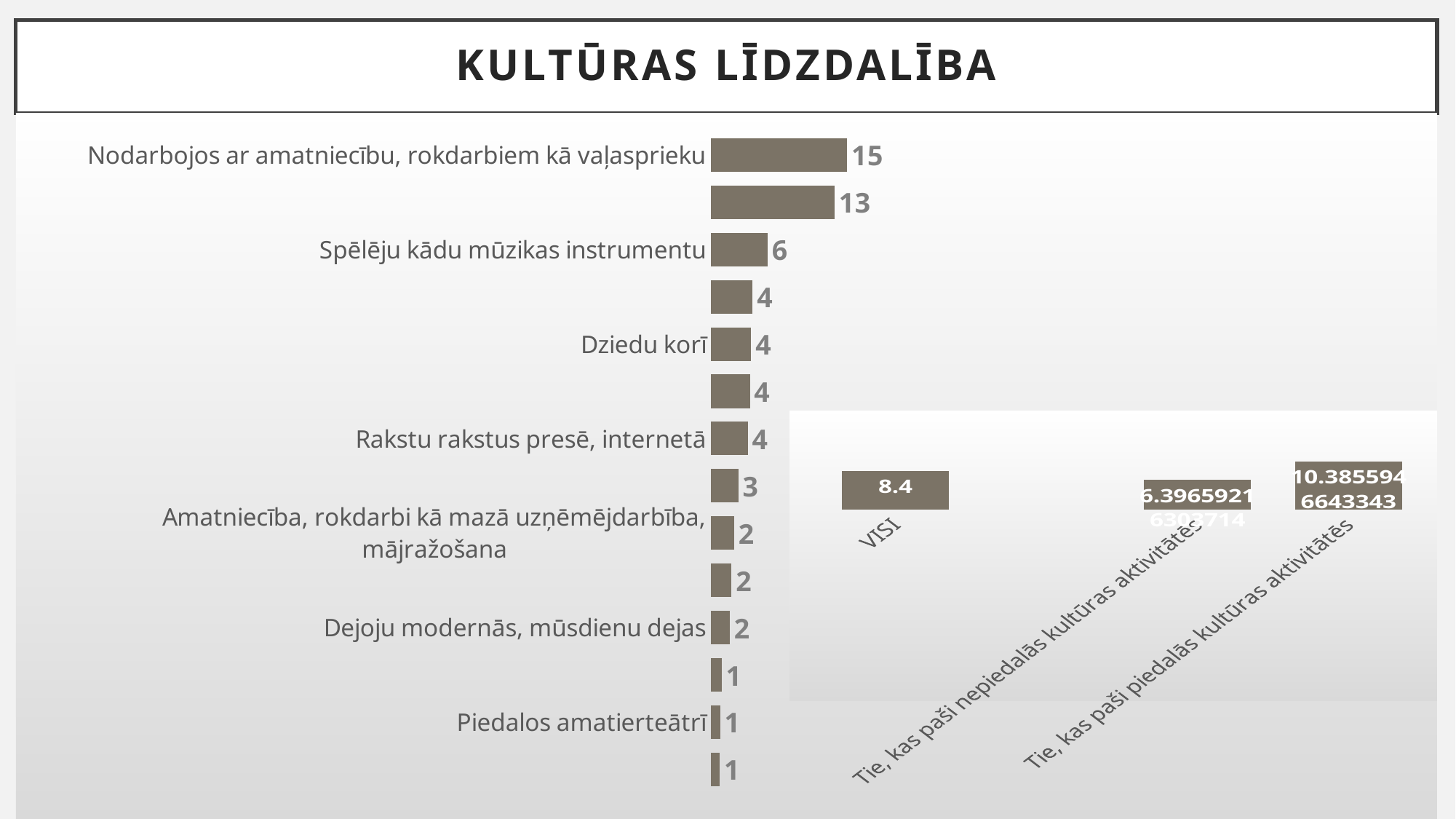
On the left horizontal bar chart, which is larger: the value for 'Spēlēju kādu mūzikas instrumentu' or for 'Dejoju modernās, mūsdienu dejas'? Spēlēju kādu mūzikas instrumentu On the left horizontal bar chart, what is the difference between the values for 'Nodarbojos ar amatniecību, rokdarbiem kā vaļasprieku' and 'Spēlēju kādu mūzikas instrumentu'? 9 On the left horizontal bar chart, which category has the highest value? Nodarbojos ar amatniecību, rokdarbiem kā vaļasprieku How many categories are shown on the small chart at the bottom right? 3 How many bars are plotted on the left horizontal bar chart? 14 On the left horizontal bar chart, what is the value for 'Piedalos amatierteātrī'? 1 On the left horizontal bar chart, what is the value for 'Spēlēju kādu mūzikas instrumentu'? 6 On the small chart at the bottom right, what is the value for 'VISI'? 8.4 On the left horizontal bar chart, what is the value for 'Dziedu korī'? 4 What kind of chart is the chart on the left of the slide? Bar chart On the left horizontal bar chart, what is the value for 'Nodarbojos ar amatniecību, rokdarbiem kā vaļasprieku'? 15 On the small chart at the bottom right, which category has the highest value? Tie, kas paši piedalās kultūras aktivitātēs